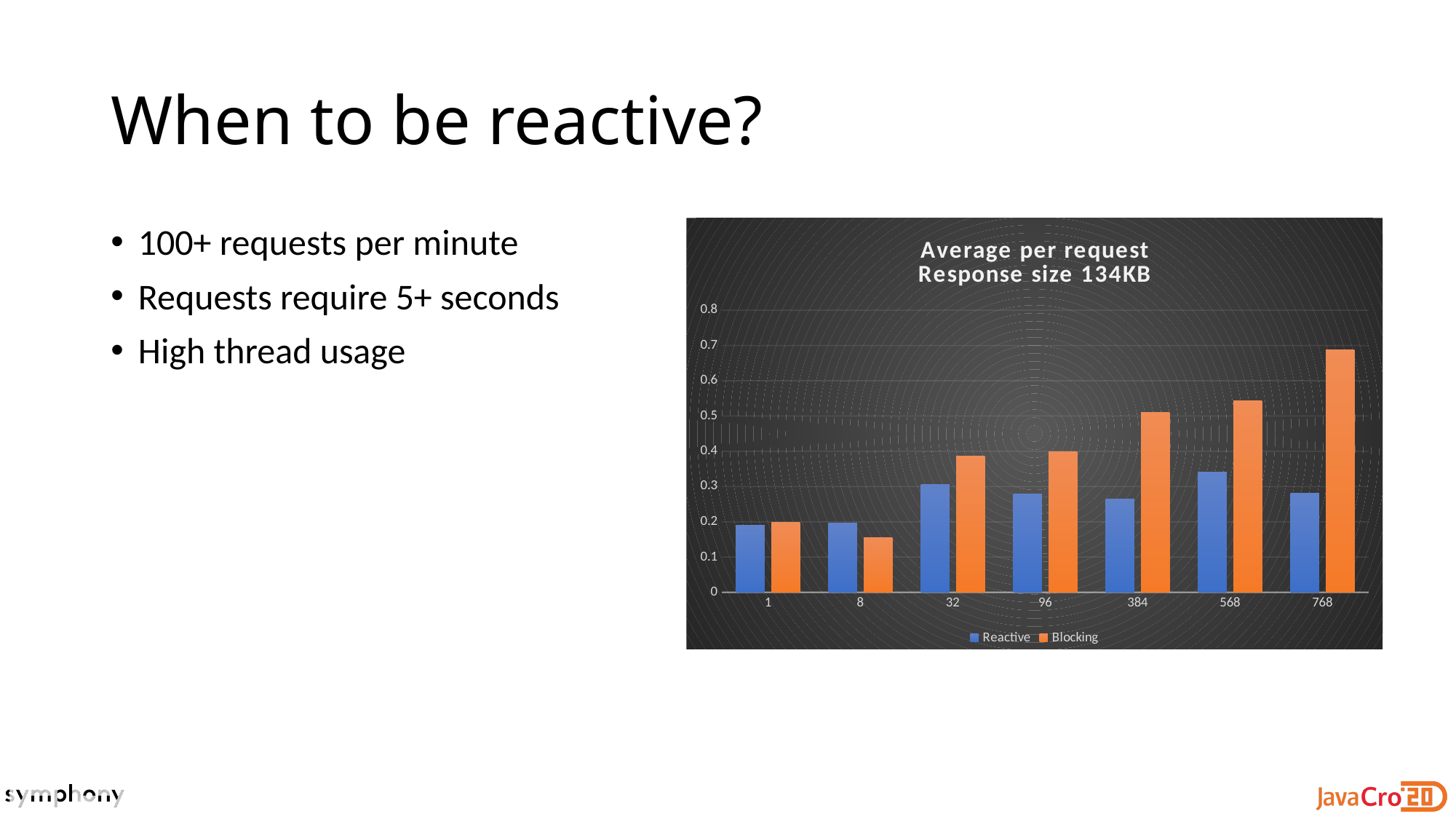
How many categories are shown on the x axis of the chart? 7 Is the Blocking value for category 768 greater or less than 0.6? greater What is the title of the chart? Average per request Response size 134KB At category 8, which series has the larger value, Reactive or Blocking? Reactive What kind of chart is shown on the slide? bar chart For which category is the Blocking value lowest? 8 How many series does the chart legend list? 2 At category 384, which series has the larger value, Reactive or Blocking? Blocking Which series is shown in orange in the chart? Blocking Is the Reactive value for category 384 greater or less than 0.3? less For which category is the Blocking value highest? 768 For which category is the Reactive value highest? 568